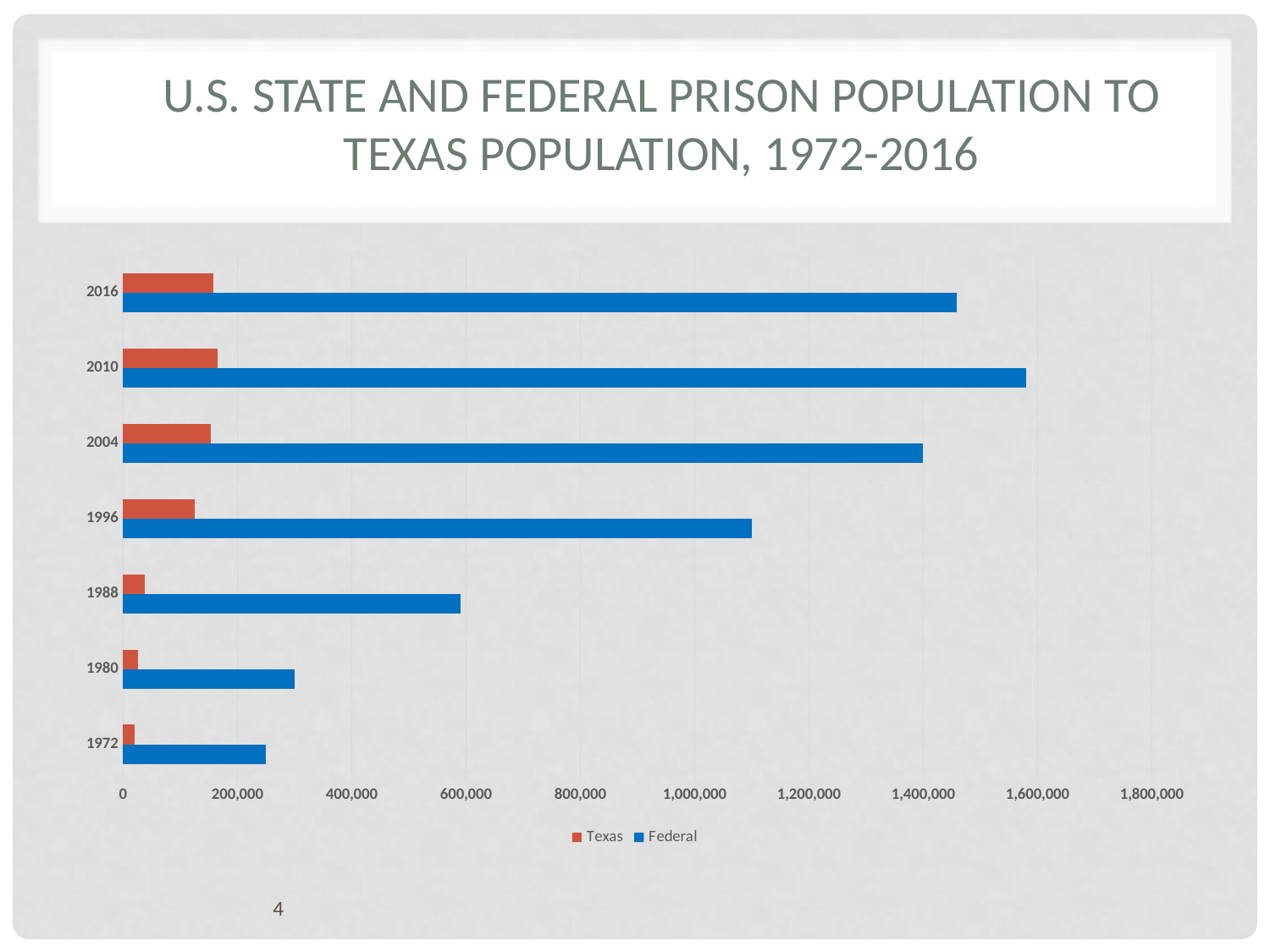
Which year has the lowest Federal value? 1972 Which year has the lowest Texas value? 1972 Is the Texas value for 2016 greater or less than 200,000? less How many series does the legend list? 2 What kind of chart is shown on the slide? bar chart How many years are shown on the vertical axis? 7 Is the Federal value for 2010 greater or less than 1,400,000? greater Does the Federal value rise or fall from 1972 to 2010? rise Which is larger, the Federal value for 2004 or the Federal value for 1996? 2004 Is the Federal value for 1996 greater or less than 1,000,000? greater Which year has the highest Federal value? 2010